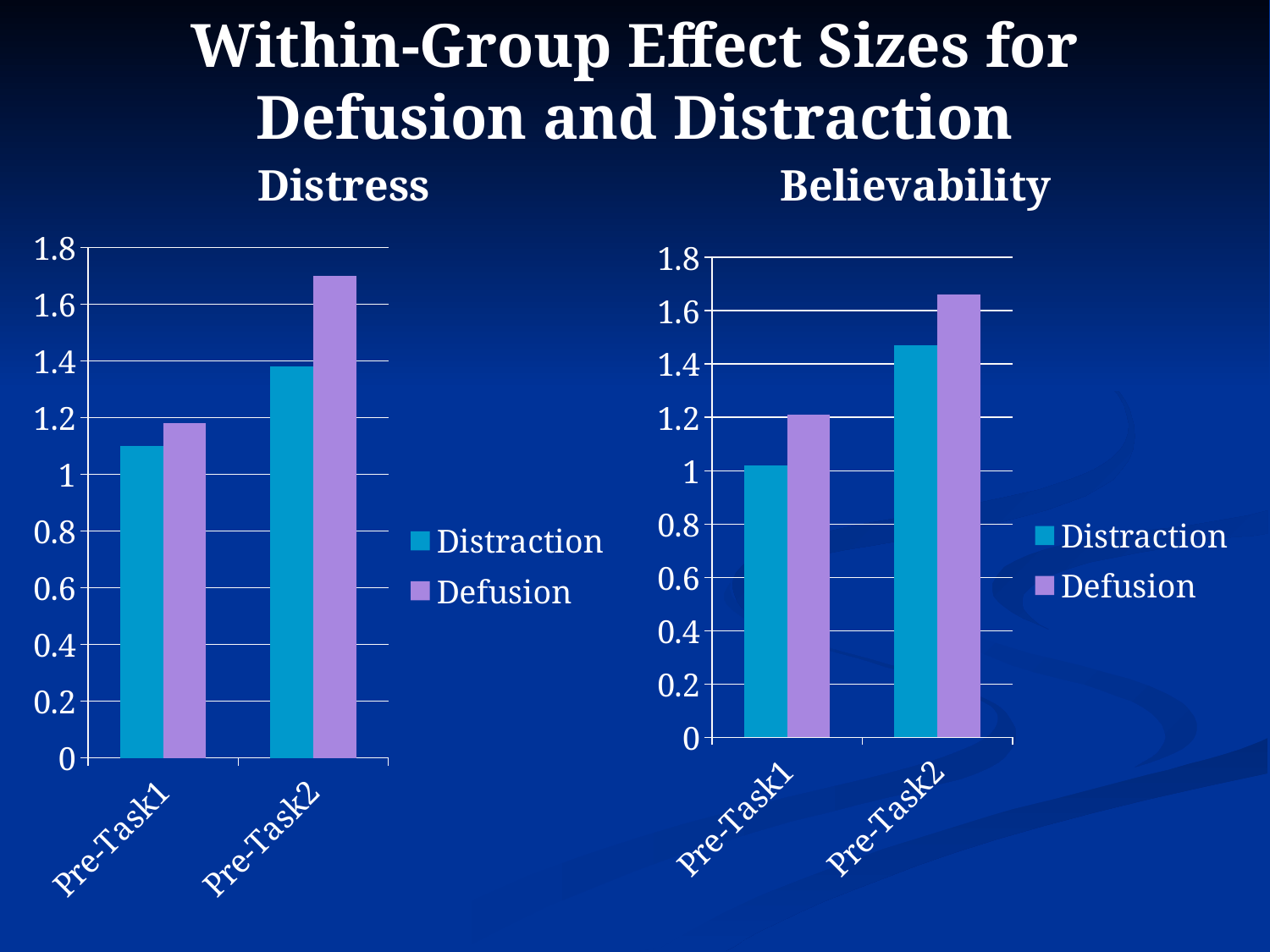
In the Believability chart, which is larger: Distraction at Pre-Task2 or Defusion at Pre-Task1? Distraction at Pre-Task2 In the Distress chart, which series has the tallest bar at Pre-Task2? Defusion How many categories are shown on the x axis of the Distress chart? 2 In the Believability chart, is the value for Distraction at Pre-Task2 greater or less than 1.4? greater What kind of chart is the Distress chart? bar chart In the Distress chart, which is larger at Pre-Task1: Distraction or Defusion? Defusion In the Believability chart, which bar is the lowest overall? Distraction at Pre-Task1 In the Believability chart, is the value for Defusion at Pre-Task1 greater or less than 1.4? less How many series does the legend of the Believability chart list? 2 In the Distress chart, is the value for Distraction at Pre-Task1 greater or less than 1.2? less In the Believability chart, do the Defusion values rise or fall from Pre-Task1 to Pre-Task2? rise